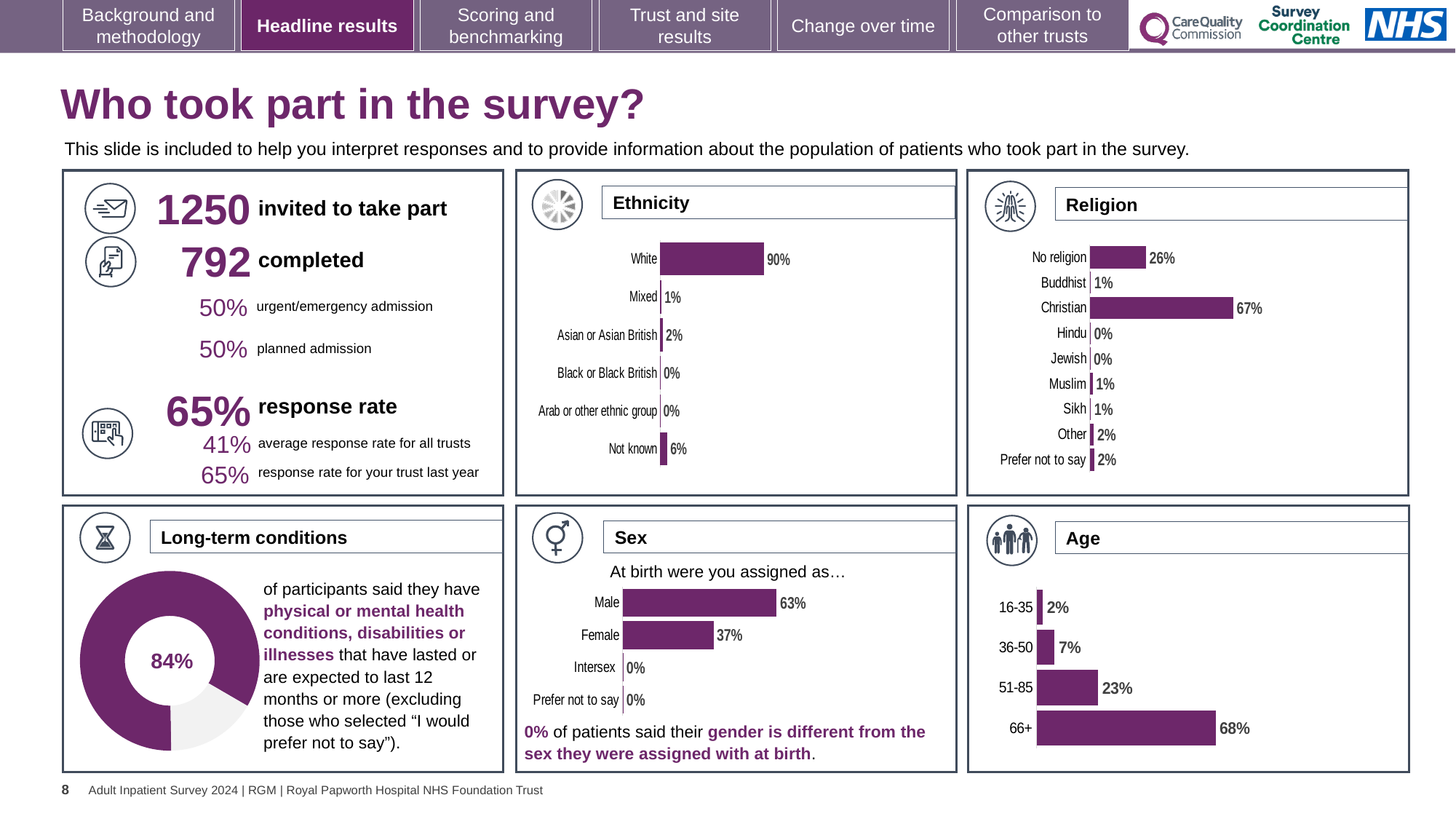
In the Age chart, do the values rise or fall as the age groups get older? rise In the Religion chart, what percentage of respondents were Christian? 67% In the Sex chart, what percentage of respondents were Female? 37% In the Sex chart, which is larger, Male or Female? Male What kind of chart is used in the Long-term conditions panel? Doughnut chart In the Ethnicity chart, what percentage of respondents were White? 90% In the Age chart, which age group has the lowest value? 16-35 In the Ethnicity chart, which category has the highest value? White In the Religion chart, how many religion categories are shown? 9 In the Ethnicity chart, what is the value for Not known? 6% In the Religion chart, what is the difference between Christian and No religion? 41% In the Age chart, what percentage of respondents were aged 66+? 68%